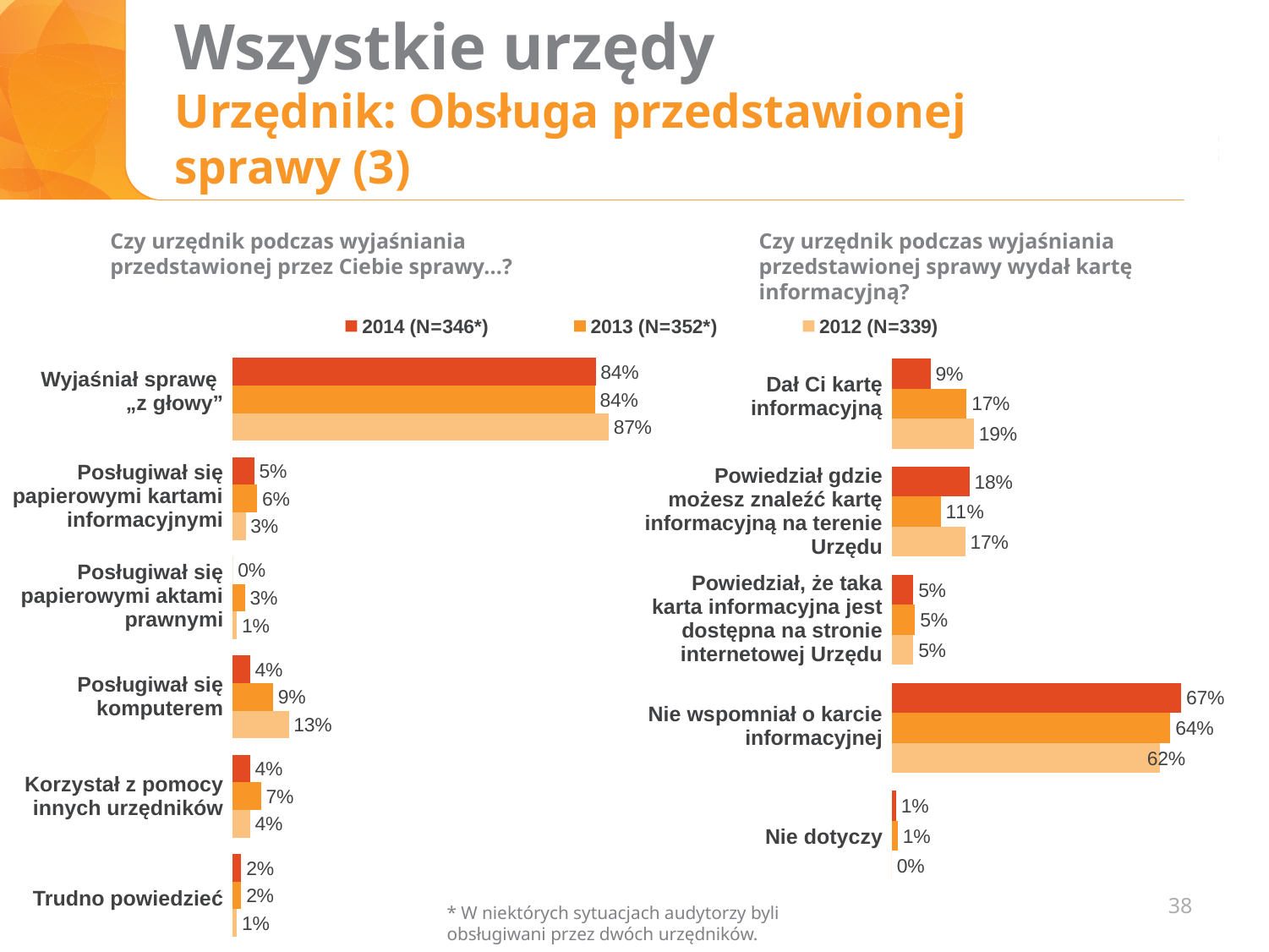
In the right chart, what is the 2013 value for "Dał Ci kartę informacyjną"? 17% In the right chart, which category has the lowest 2012 value? Nie dotyczy In the left chart, which is larger for "Posługiwał się komputerem": the 2014 value or the 2012 value? 2012 In the left chart, which category has the highest 2014 value? Wyjaśniał sprawę „z głowy” In the right chart ("Czy urzędnik podczas wyjaśniania przedstawionej sprawy wydał kartę informacyjną?"), what is the 2014 value for "Nie wspomniał o karcie informacyjnej"? 67% In the left chart ("Czy urzędnik podczas wyjaśniania przedstawionej przez Ciebie sprawy...?"), what is the 2012 value for "Wyjaśniał sprawę „z głowy”"? 87% In the right chart, how do the values for "Dał Ci kartę informacyjną" change from 2014 to 2012? They rise In the left chart, what is the 2013 value for "Posługiwał się komputerem"? 9% How many categories does the left chart show? 6 How many series does the legend list? 3 What type of chart is the right chart? Bar chart In the right chart, what is the difference between the 2014 and 2012 values for "Nie wspomniał o karcie informacyjnej"? 5%